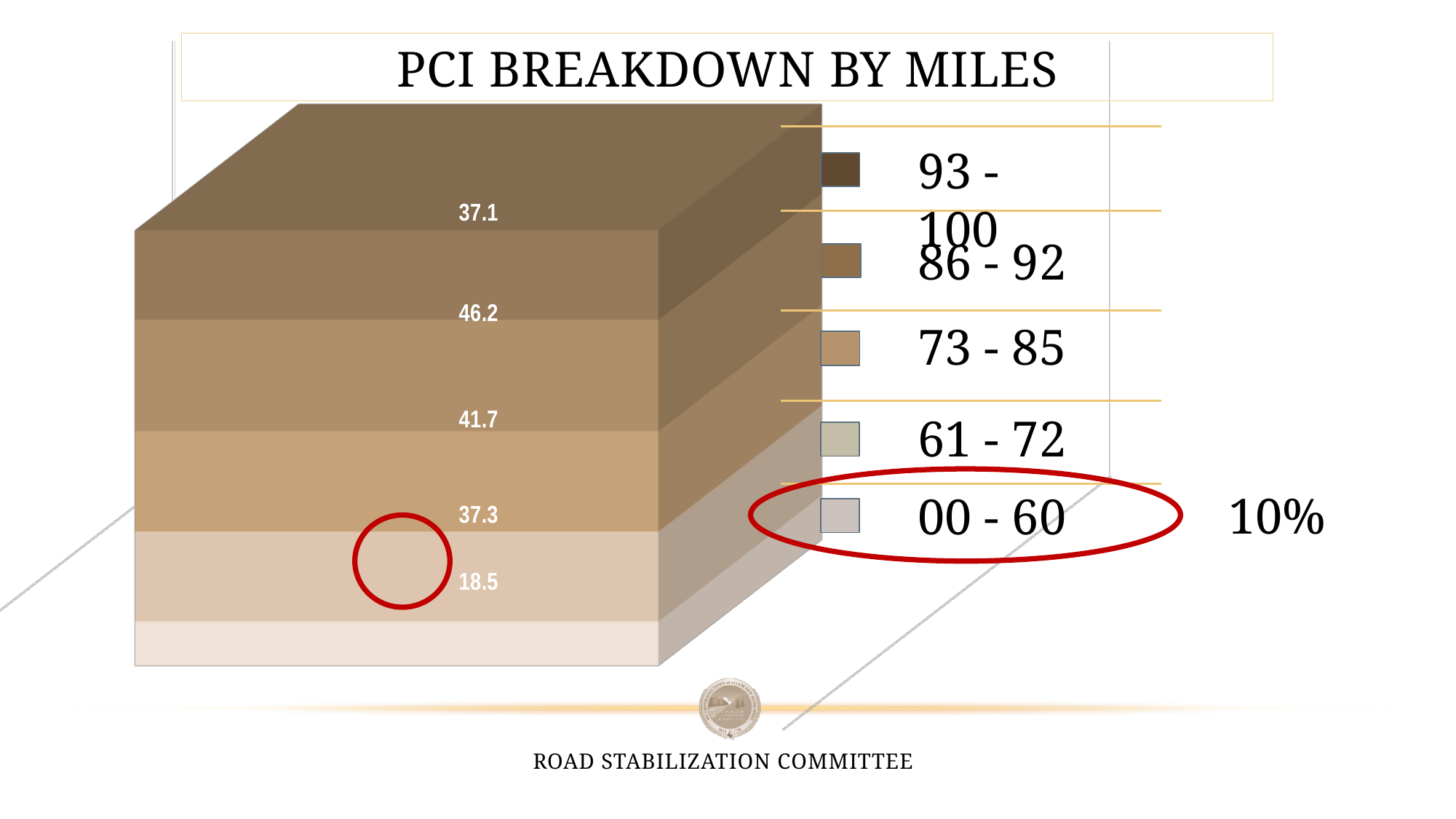
What is the total of all segments in the stacked bar? 180.8 What is the value for the 61 - 72 segment? 37.3 What is the value for the 00 - 60 segment? 18.5 What kind of chart is shown on the slide? stacked bar chart What is the value for the 86 - 92 segment? 46.2 What is the title of the chart? PCI BREAKDOWN BY MILES Which PCI range has the smallest value? 00 - 60 What is the difference between the 86 - 92 value and the 00 - 60 value? 27.7 What is the value for the 73 - 85 segment? 41.7 Which PCI range has the largest value? 86 - 92 What is the value for the 93 - 100 segment? 37.1 How many series does the legend list? 5